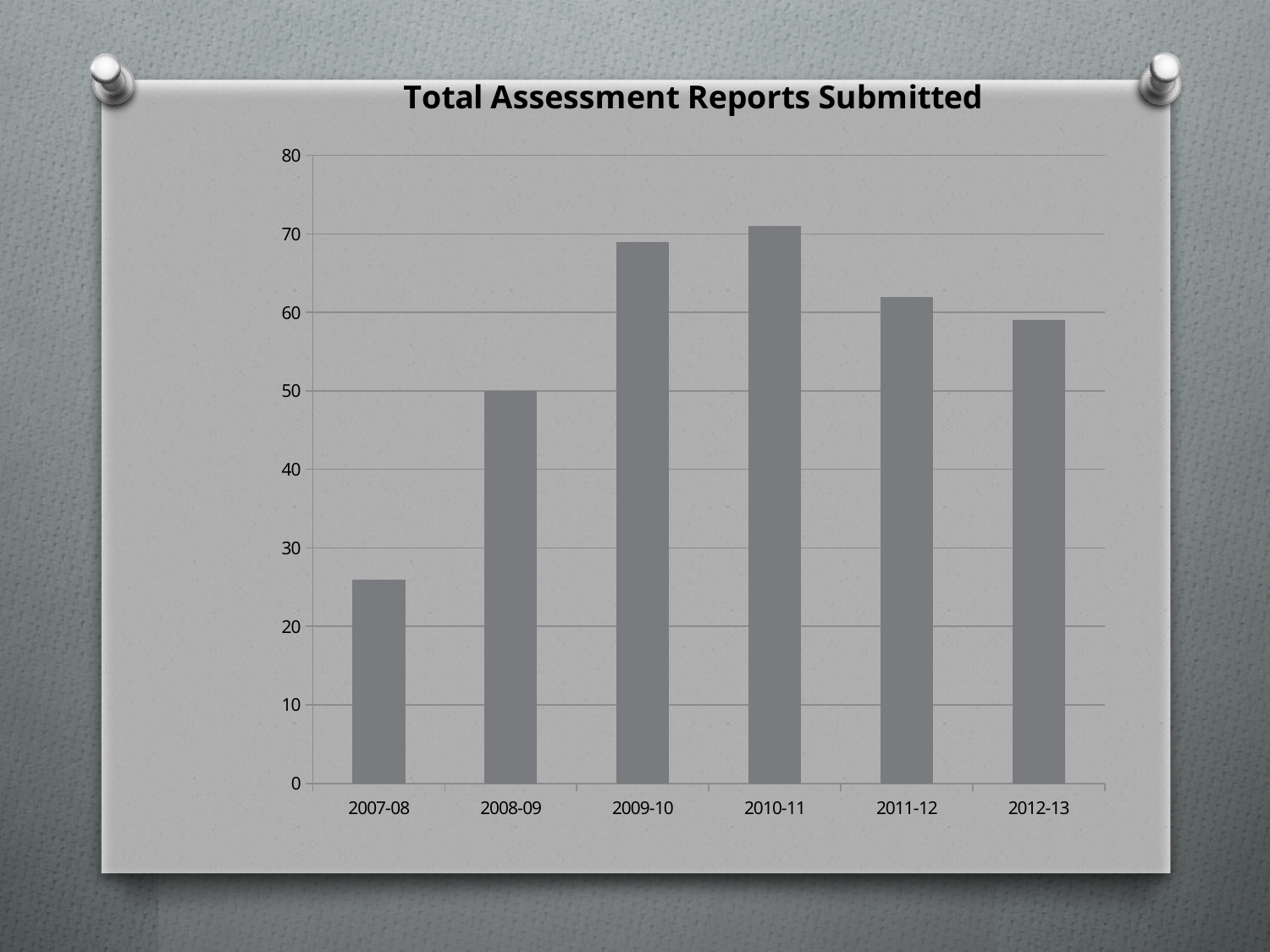
What is the value for 2008-09? 50 Is the value for 2007-08 greater or less than 30? less Is the value for 2010-11 greater or less than 70? greater What kind of chart is shown on the slide? Bar chart Which year has the highest number of assessment reports submitted? 2010-11 Do the values rise or fall from 2007-08 to 2010-11? rise Which year has the lowest number of assessment reports submitted? 2007-08 Is the value for 2012-13 greater or less than 60? less What is the title of the chart? Total Assessment Reports Submitted Which is larger, the value for 2011-12 or the value for 2012-13? 2011-12 How many academic years are shown on the x axis of the chart? 6